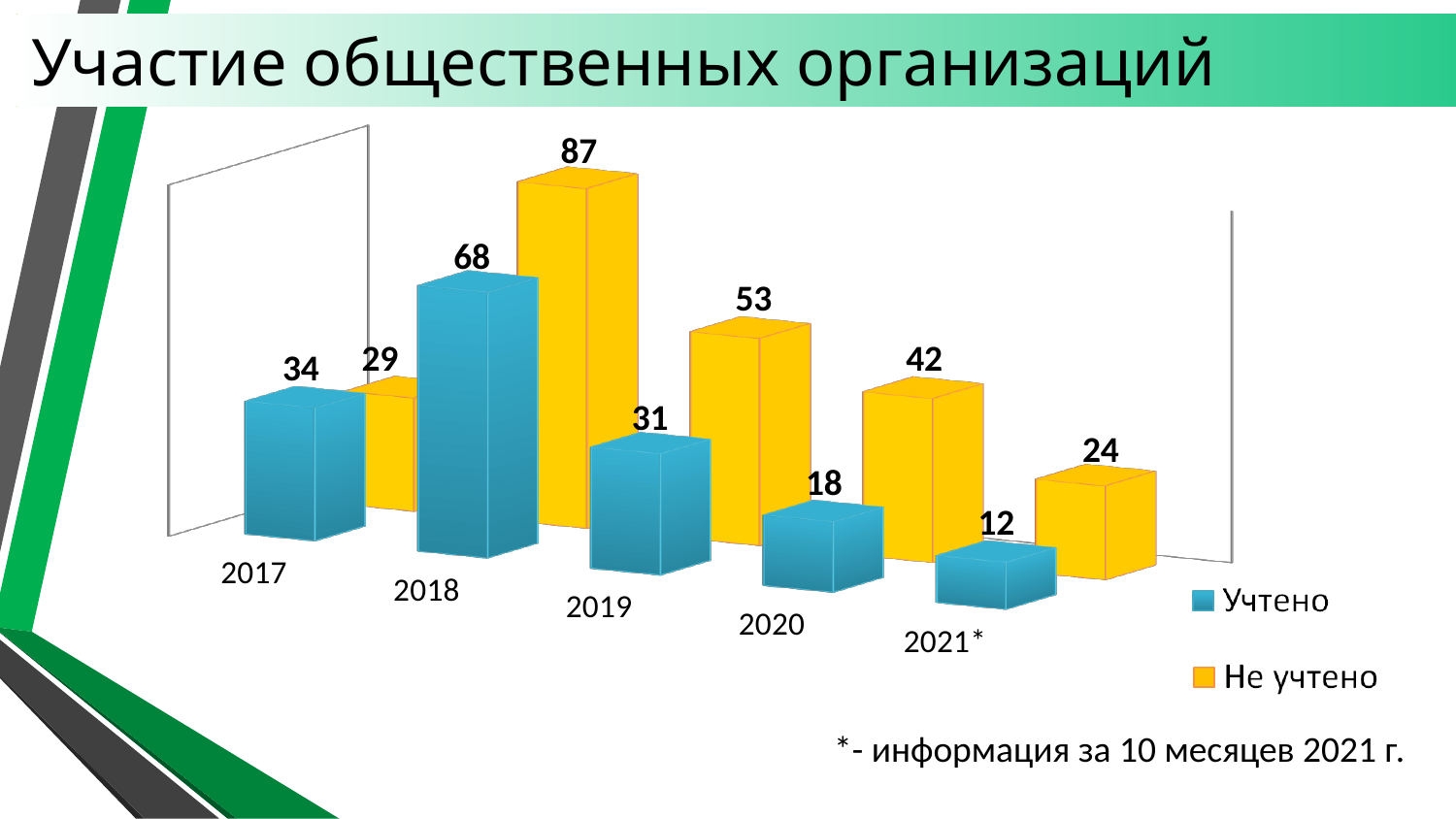
What is the value for Учтено in 2018? 68 Which is larger in 2017, Учтено or Не учтено? Учтено What is the value for Не учтено in 2019? 53 Which year has the lowest value for Учтено? 2021* What is the title of the slide? Участие общественных организаций How many series does the legend list? 2 How many years are shown on the x axis? 5 What kind of chart is shown on the slide? Bar chart Does the value for Учтено rise or fall from 2018 to 2021*? Fall What is the value for Учтено in 2021*? 12 Which year has the highest value for Не учтено? 2018 What is the difference between Не учтено and Учтено in 2020? 24